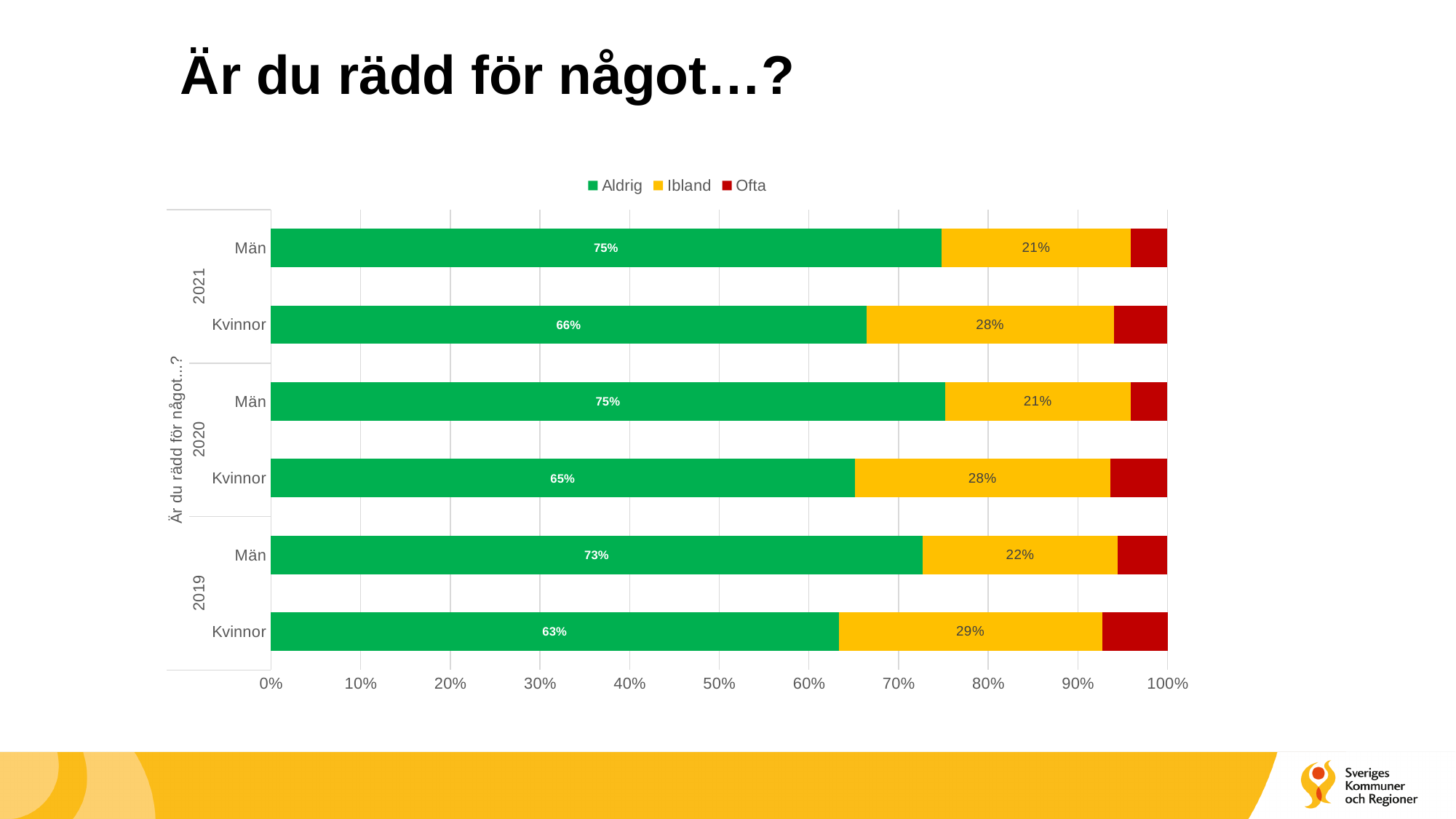
What is the Aldrig value for Män in 2021? 75% How many bars are plotted in the chart? 6 What is the Aldrig value for Kvinnor in 2020? 65% Which legend entry is shown in red? Ofta Is the Ofta value for Kvinnor in 2019 greater or less than 10%? less What is the Ibland value for Kvinnor in 2019? 29% Which is larger, the Ibland value for Kvinnor in 2021 or for Män in 2021? Kvinnor in 2021 What is the Ibland value for Män in 2019? 22% Which bar has the lowest Aldrig value? Kvinnor 2019 What kind of chart is shown on the slide? Stacked bar chart How many series does the legend list? 3 What is the difference between the Aldrig values for Män and Kvinnor in 2019? 10%